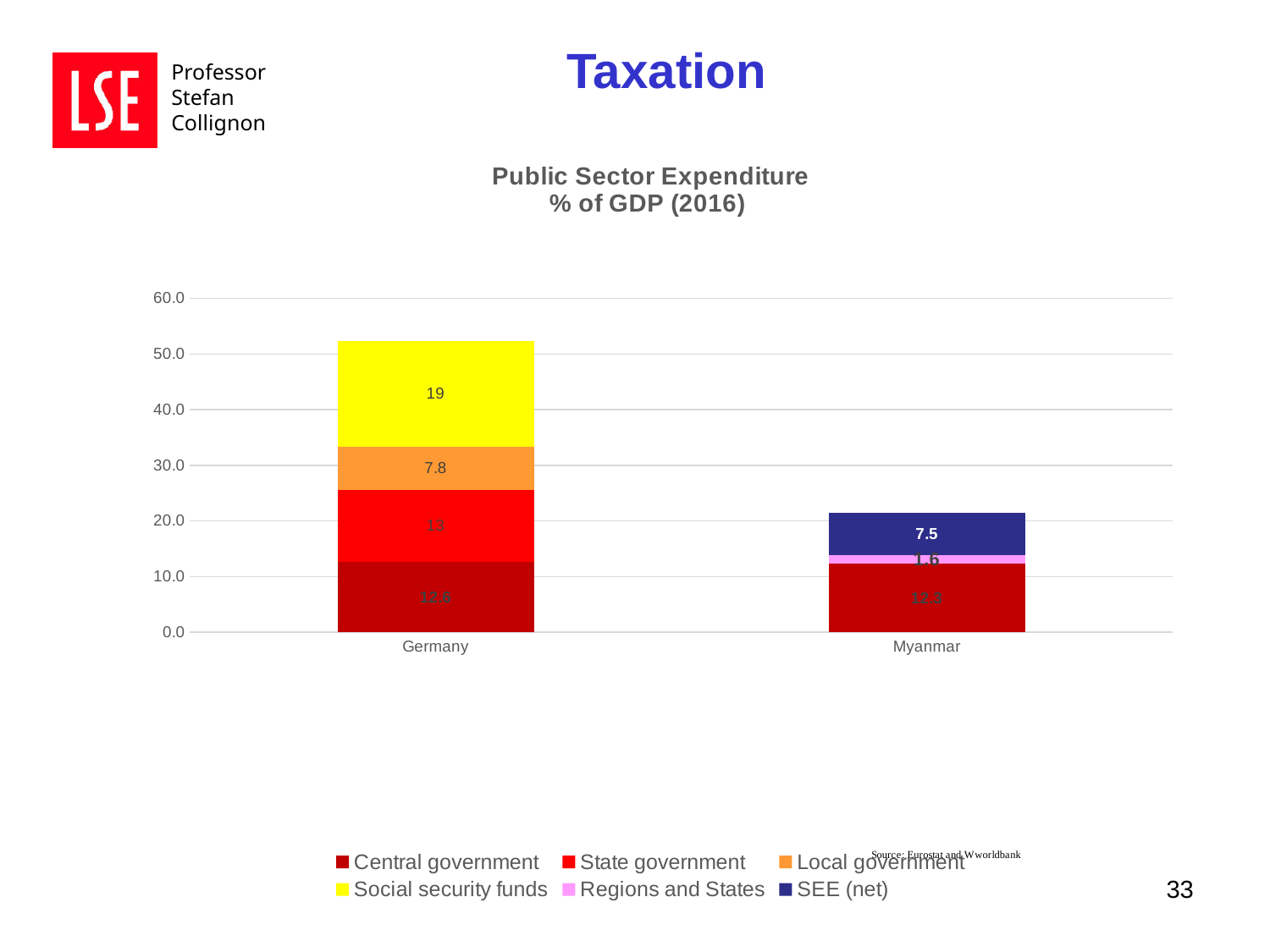
What kind of chart is shown on the slide? Stacked bar chart Which country has the taller stacked bar overall? Germany How many series does the legend list? 6 For Germany, which is larger: State government or Local government? State government What is the value for Regions and States for Myanmar? 1.6 What is the value for Social security funds for Germany? 19 How many countries are shown on the x axis? 2 What is the value for Local government for Germany? 7.8 Is the total height of the Germany bar greater or less than 50.0? greater What is the difference between the Social security funds value and the Local government value for Germany? 11.2 What is the value for SEE (net) for Myanmar? 7.5 What is the value for State government for Germany? 13